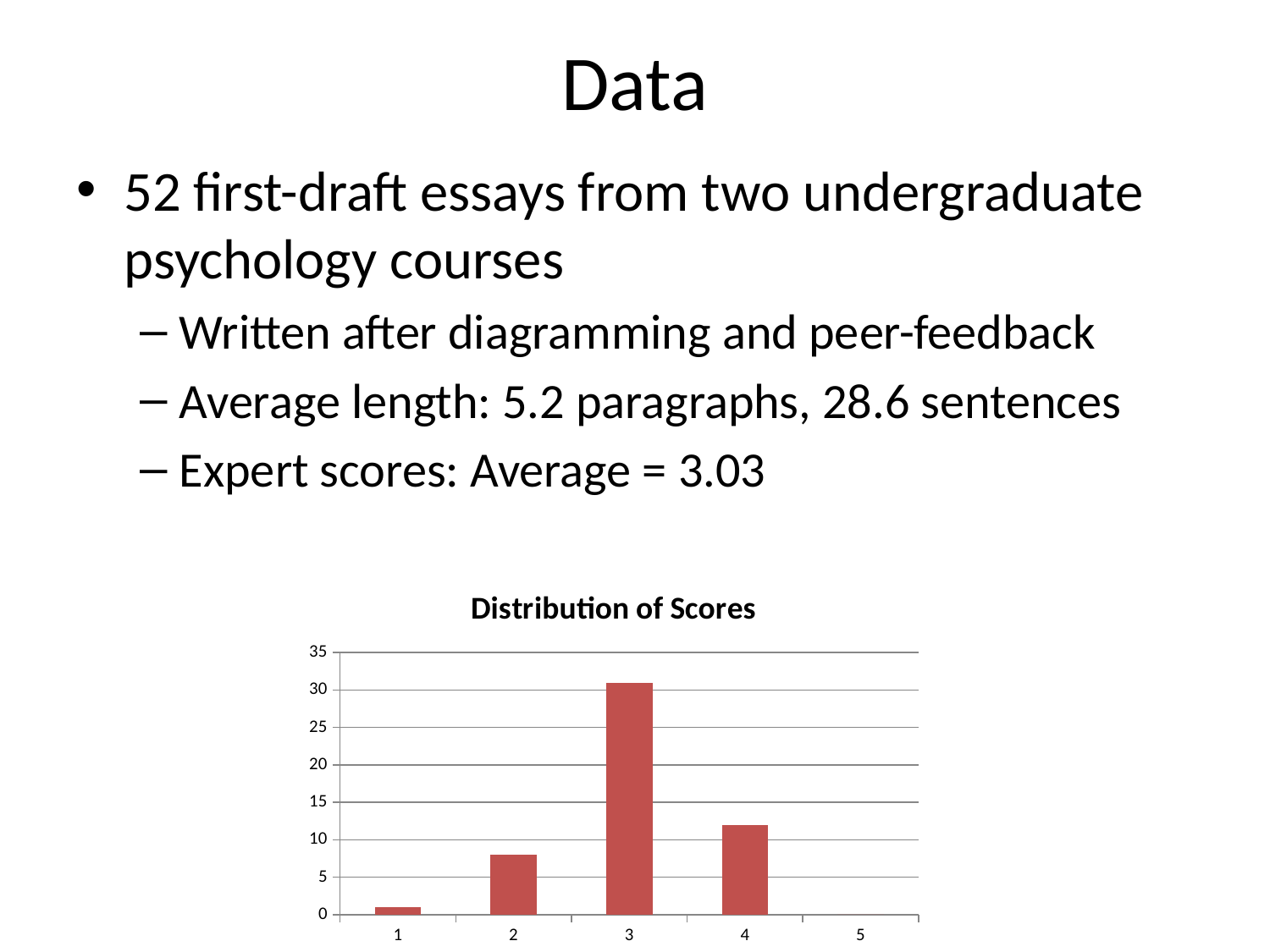
Which has a larger value in the chart, score 2 or score 4? 4 How many score categories are shown on the x axis of the chart? 5 Which score category has the tallest bar in the chart? 3 Is the value for score 1 greater or less than 5? less Is the value for score 2 greater or less than 10? less Which score category has the lowest value in the chart? 5 What kind of chart is shown under the title "Distribution of Scores"? bar chart Is the value for score 3 greater or less than 25? greater What is the title of the chart on the slide? Distribution of Scores What colour are the bars in the chart? red Which has a larger value in the chart, score 3 or score 4? 3